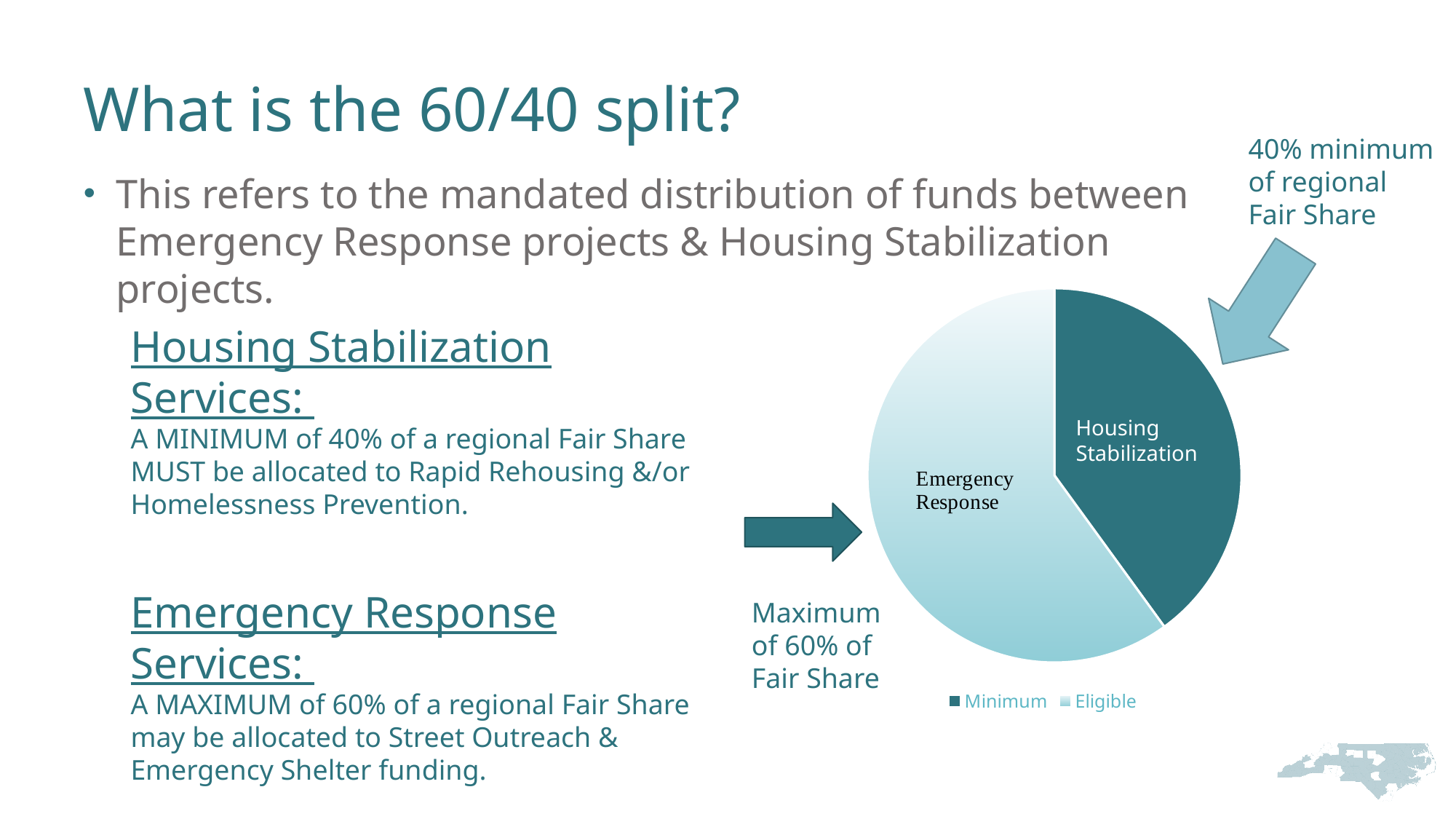
What are the two legend entries of the pie chart? Minimum and Eligible Which slice of the pie chart is the smallest? Housing Stabilization What kind of chart is shown on the slide? pie chart What share of the pie does the Emergency Response slice represent, according to the annotation pointing to it? 60% Which slice of the pie chart is larger, Housing Stabilization or Emergency Response? Emergency Response Which slice of the pie chart is the largest? Emergency Response What is the difference in percentage points between the Emergency Response share (60%) and the Housing Stabilization share (40%)? 20 percentage points What share of the pie does the Housing Stabilization slice represent, according to the annotation pointing to it? 40% How many slices does the pie chart have? 2 How many entries does the pie chart's legend list? 2 Which slice of the pie chart is drawn in the darker teal colour? Housing Stabilization